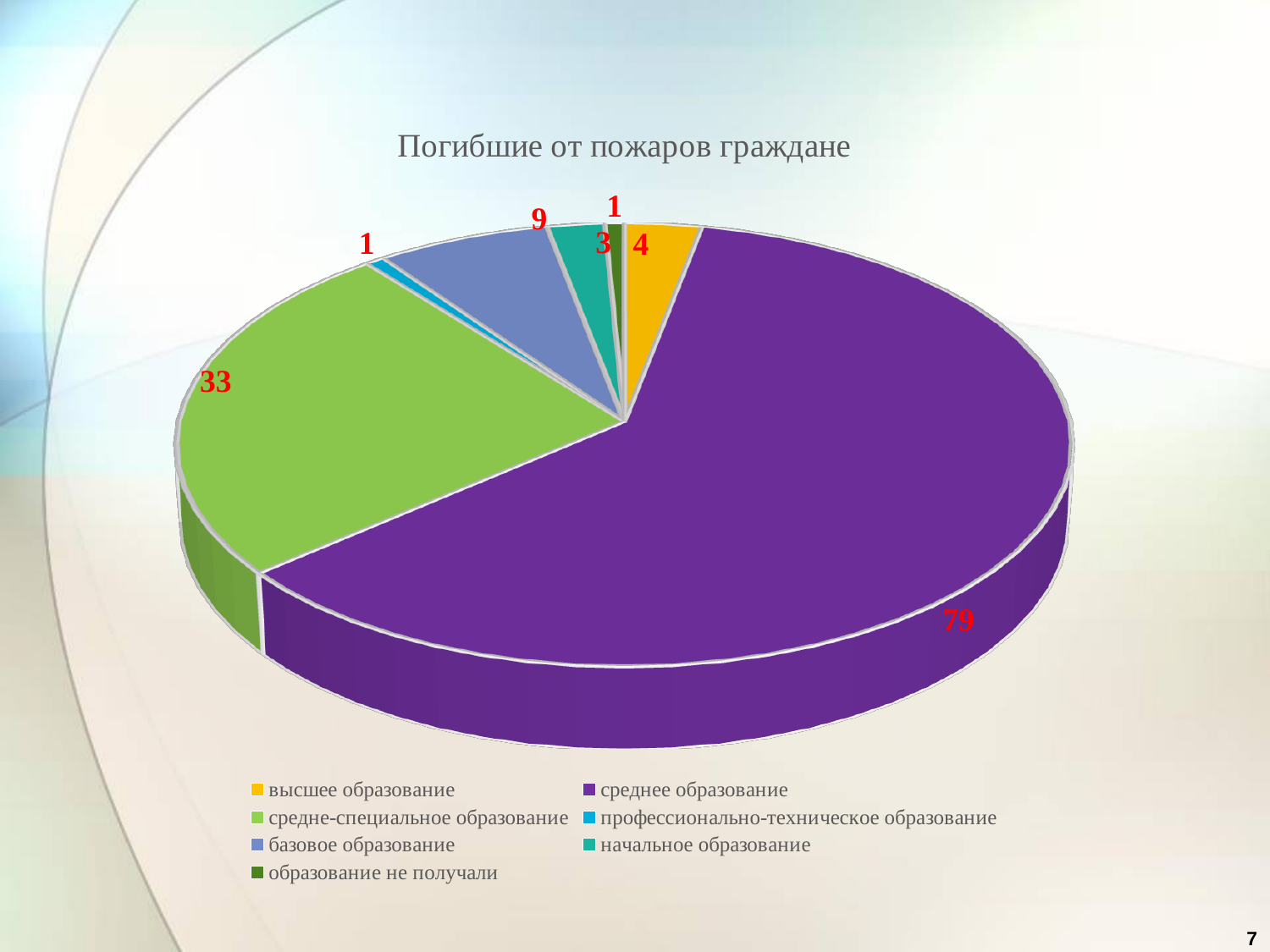
How many categories does the legend of the chart list? 7 What is the value for среднее образование? 79 What is the value for средне-специальное образование? 33 Which category has the largest slice of the pie? среднее образование What is the title of the chart? Погибшие от пожаров граждане What is the value for начальное образование? 3 Which is larger, the value for базовое образование or the value for высшее образование? базовое образование What is the difference between the values for среднее образование and средне-специальное образование? 46 What is the value for высшее образование? 4 What is the value for базовое образование? 9 What colour is the slice for среднее образование? purple What kind of chart is shown on the slide? pie chart